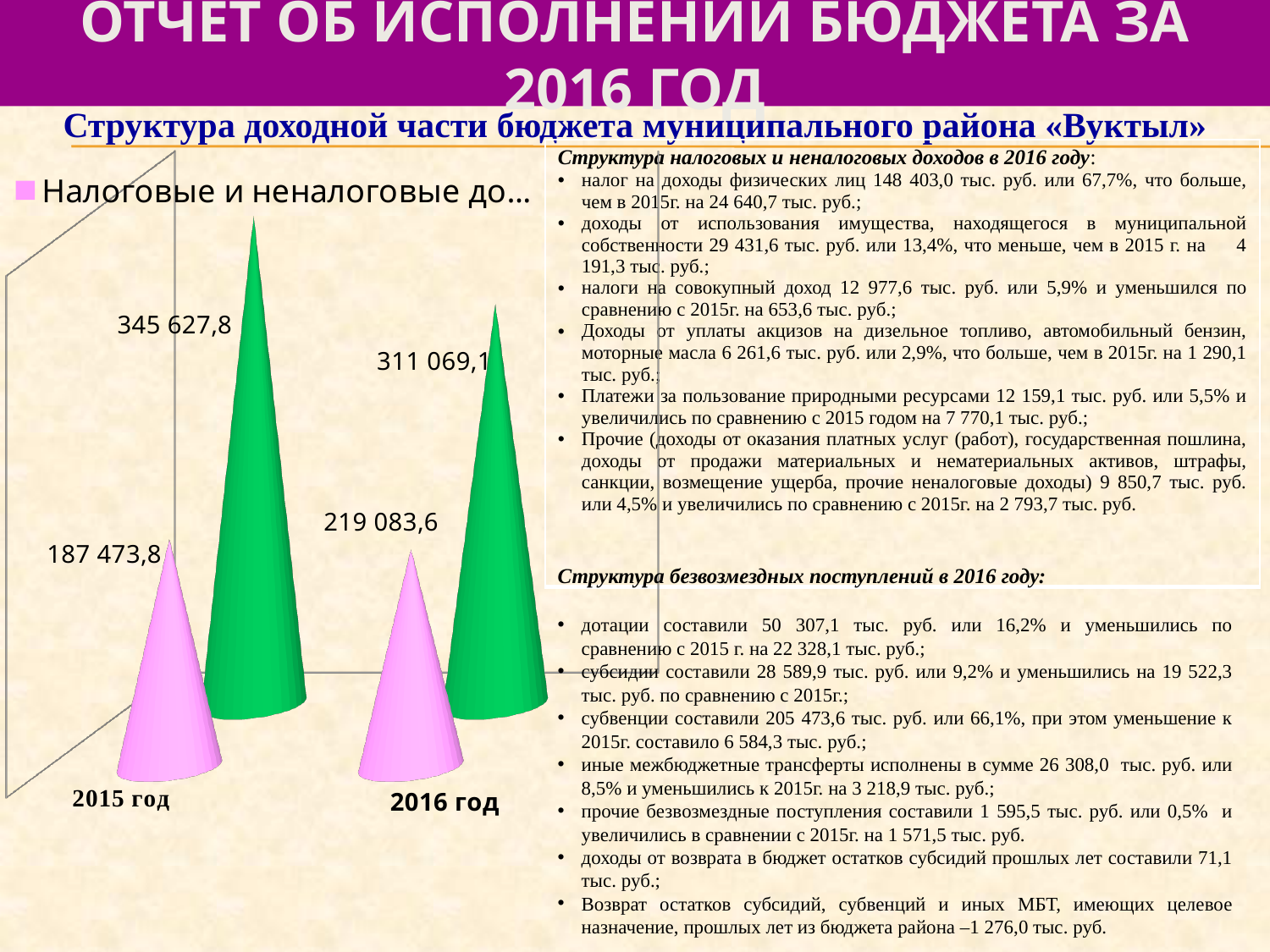
By how much did the pink series (Налоговые и неналоговые доходы) increase from 2015 год to 2016 год? 31 609,8 What kind of chart is shown on the slide? bar chart What is the value of the pink series (Налоговые и неналоговые доходы) for 2016 год? 219 083,6 What is the value of the green series for 2016 год? 311 069,1 In 2015 год, which series has the larger value, the pink or the green? green Which year has the larger value for the pink series (Налоговые и неналоговые доходы)? 2016 год What is the difference between the green series values for 2015 год and 2016 год? 34 558,7 Does the pink series (Налоговые и неналоговые доходы) rise or fall from 2015 год to 2016 год? rise What is the value of the pink series (Налоговые и неналоговые доходы) for 2015 год? 187 473,8 How many years (categories) are shown on the chart? 2 What is the value of the green series for 2015 год? 345 627,8 In which year is the green series higher? 2015 год